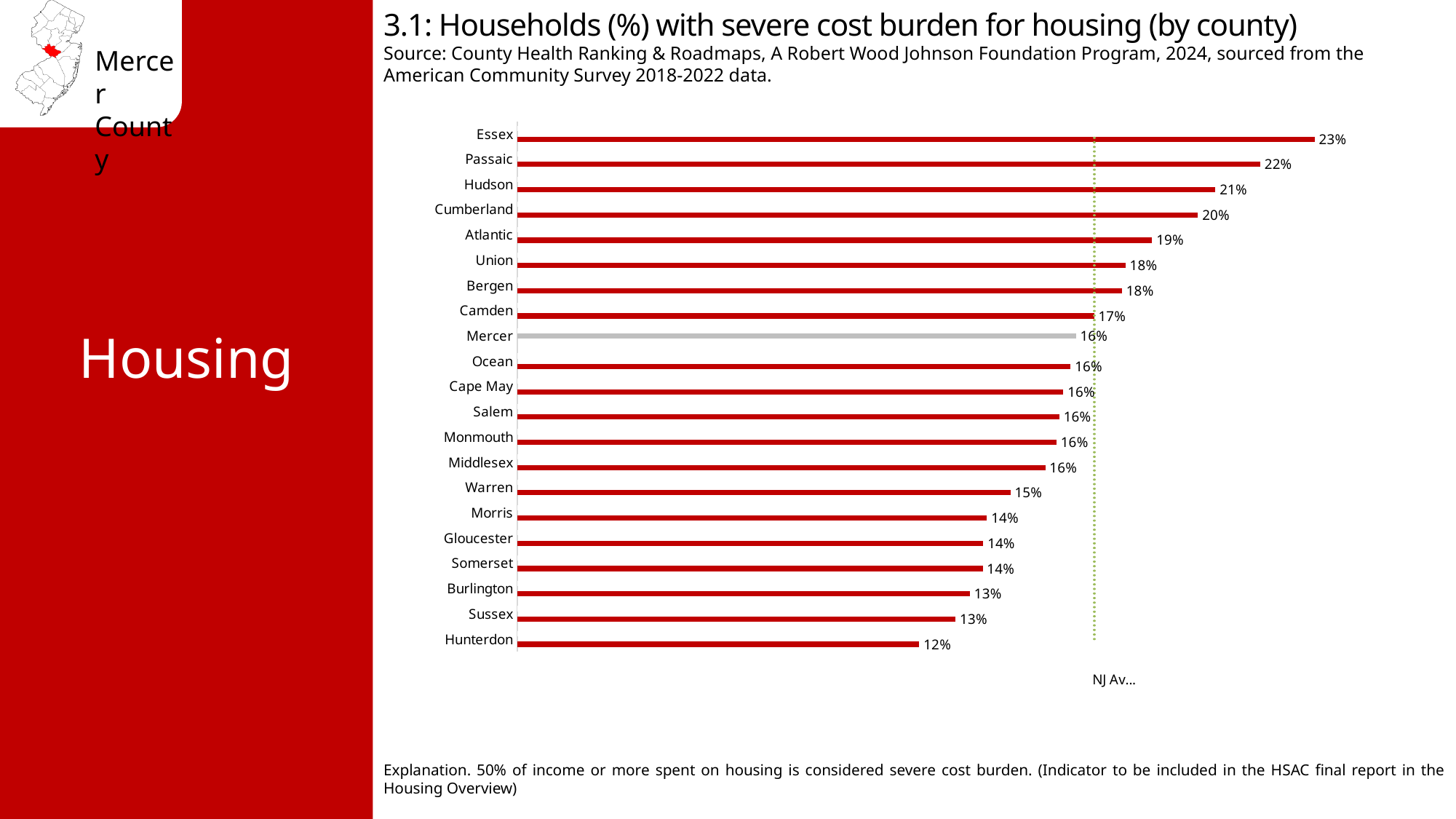
What is the value for Hunterdon? 12% Which county's bar is coloured grey instead of red? Mercer What is the value for Essex? 23% Which is larger, the value for Atlantic or the value for Warren? Atlantic What is the value for Camden? 17% Which county has the highest value? Essex What is the difference between the values for Essex and Hunterdon? 11% What kind of chart is this? Bar chart Which county has the lowest value? Hunterdon How many counties are shown in the chart? 21 What is the value for Mercer? 16% What is the difference between the values for Passaic and Mercer? 6%